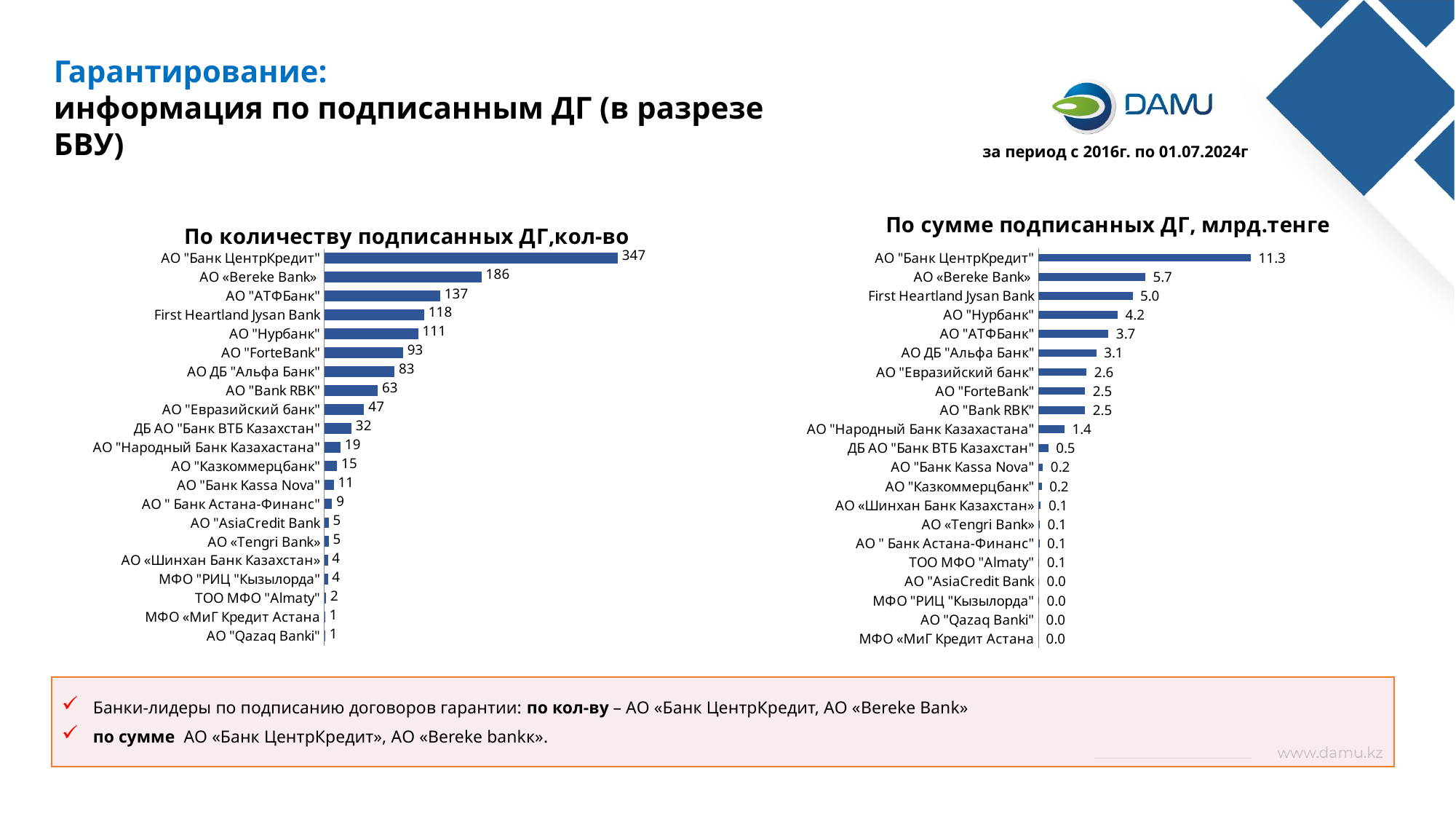
In the chart 'По количеству подписанных ДГ,кол-во', which category has the highest value? АО "Банк ЦентрКредит" In the chart 'По количеству подписанных ДГ,кол-во', what is the value for АО "Банк ЦентрКредит"? 347 In the chart 'По сумме подписанных ДГ, млрд.тенге', what is the difference between АО "Банк ЦентрКредит" and АО «Bereke Bank»? 5.6 What period is stated on the slide for the data? за период с 2016г. по 01.07.2024г In the chart 'По сумме подписанных ДГ, млрд.тенге', what is the value for АО "Народный Банк Казахастана"? 1.4 What type of chart is 'По количеству подписанных ДГ,кол-во'? Bar chart In the chart 'По количеству подписанных ДГ,кол-во', what is the difference between АО «Bereke Bank» and АО "АТФБанк"? 49 In the chart 'По сумме подписанных ДГ, млрд.тенге', what is the value for АО "Нурбанк"? 4.2 How many categories are shown in the chart 'По сумме подписанных ДГ, млрд.тенге'? 21 In the chart 'По количеству подписанных ДГ,кол-во', which is larger: АО "Нурбанк" or First Heartland Jysan Bank? First Heartland Jysan Bank In the chart 'По сумме подписанных ДГ, млрд.тенге', which category has the highest value? АО "Банк ЦентрКредит" In the chart 'По количеству подписанных ДГ,кол-во', what is the value for АО "ForteBank"? 93